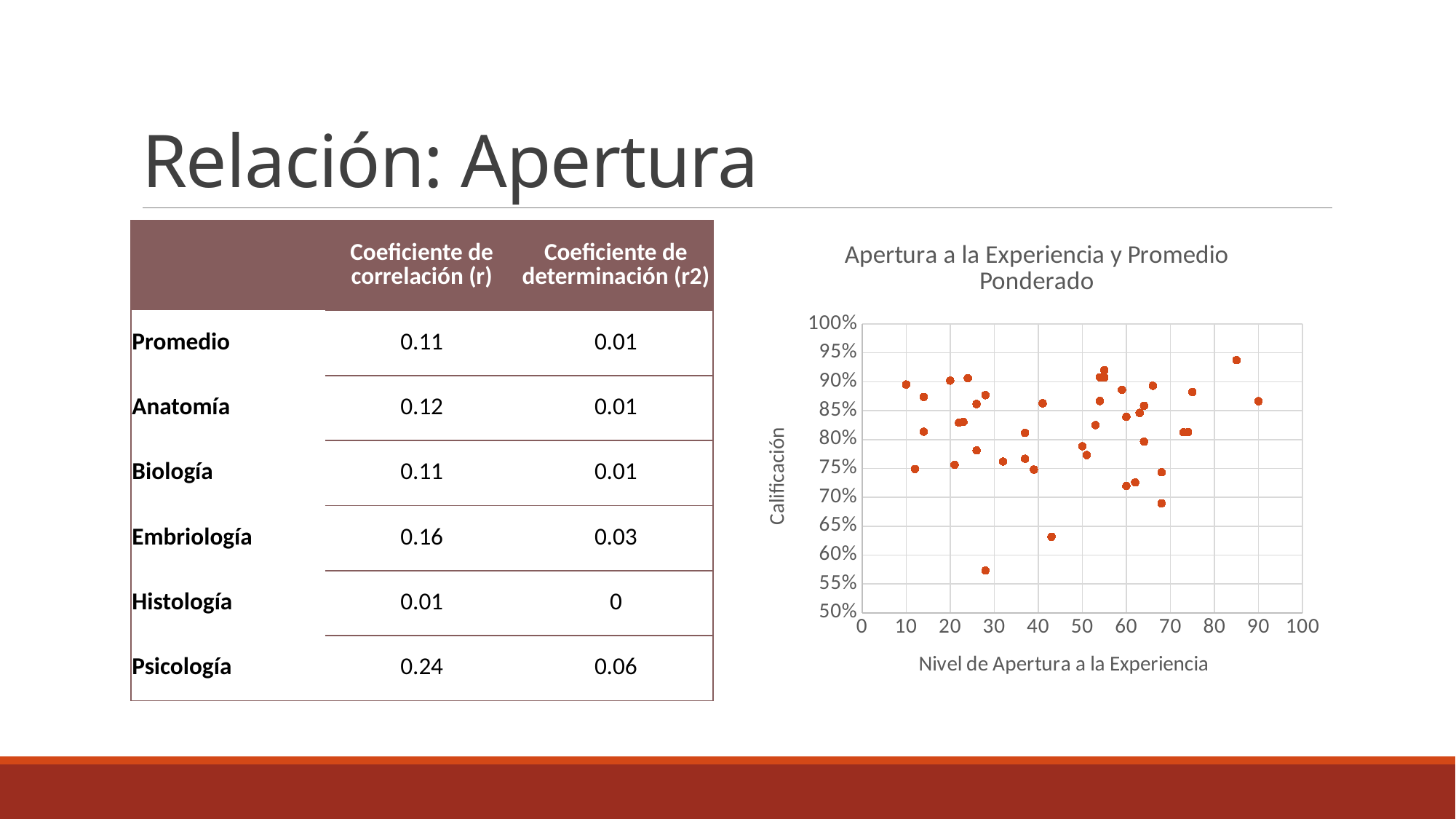
What is the label of the horizontal axis of the chart? Nivel de Apertura a la Experiencia Is the Calificación of the highest point in the chart greater or less than 95%? less Is the Nivel de Apertura a la Experiencia of the lowest point in the chart greater or less than 40? less What kind of chart is shown on the slide? scatter chart Is the Calificación of the highest point in the chart greater or less than 90%? greater What is the title of the chart on the slide? Apertura a la Experiencia y Promedio Ponderado